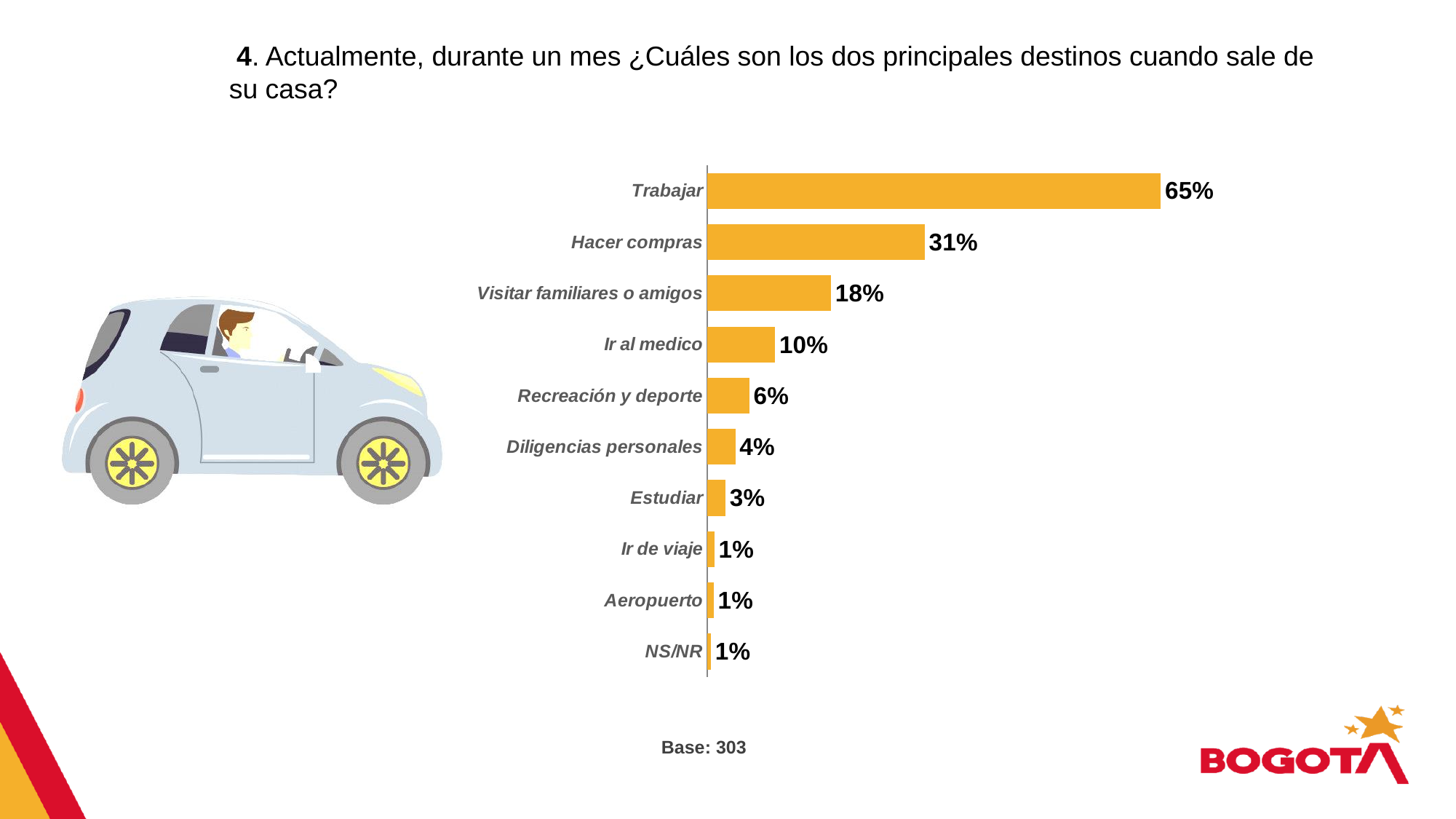
What is the value for Trabajar? 65% What colour are the bars in the chart? Orange What kind of chart is shown on the slide? Bar chart What is the difference between the values for Ir al medico and Diligencias personales? 6% What is the value for Visitar familiares o amigos? 18% What is the difference between the values for Trabajar and Hacer compras? 34% What is the value for Hacer compras? 31% What is the base (number of respondents) shown below the chart? 303 Which is larger, the value for Estudiar or the value for Diligencias personales? Diligencias personales What is the value for Recreación y deporte? 6% How many categories are shown in the chart? 10 Which category has the highest value? Trabajar